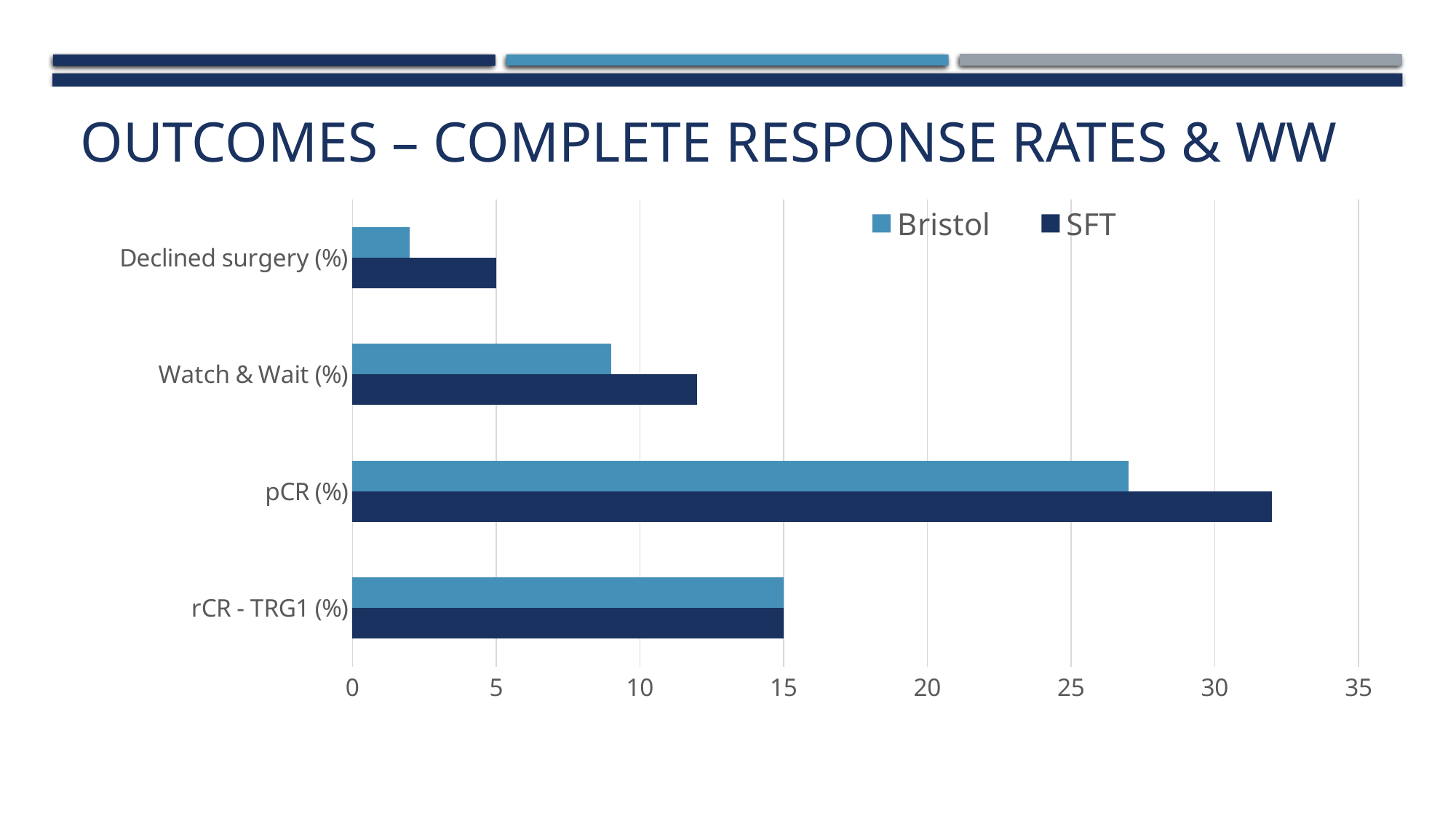
What is the SFT value for Declined surgery (%)? 5 Which category has the highest SFT value? pCR (%) Which category has the lowest Bristol value? Declined surgery (%) What is the SFT value for rCR - TRG1 (%)? 15 What is the Bristol value for rCR - TRG1 (%)? 15 Is the Bristol value for Watch & Wait (%) greater or less than 10? less Which series is shown in the darker navy colour? SFT For pCR (%), which is larger, the Bristol value or the SFT value? SFT Is the SFT value for pCR (%) greater or less than 30? greater How many series does the legend list? 2 What kind of chart is shown on the slide? Bar chart How many categories are plotted on the chart? 4